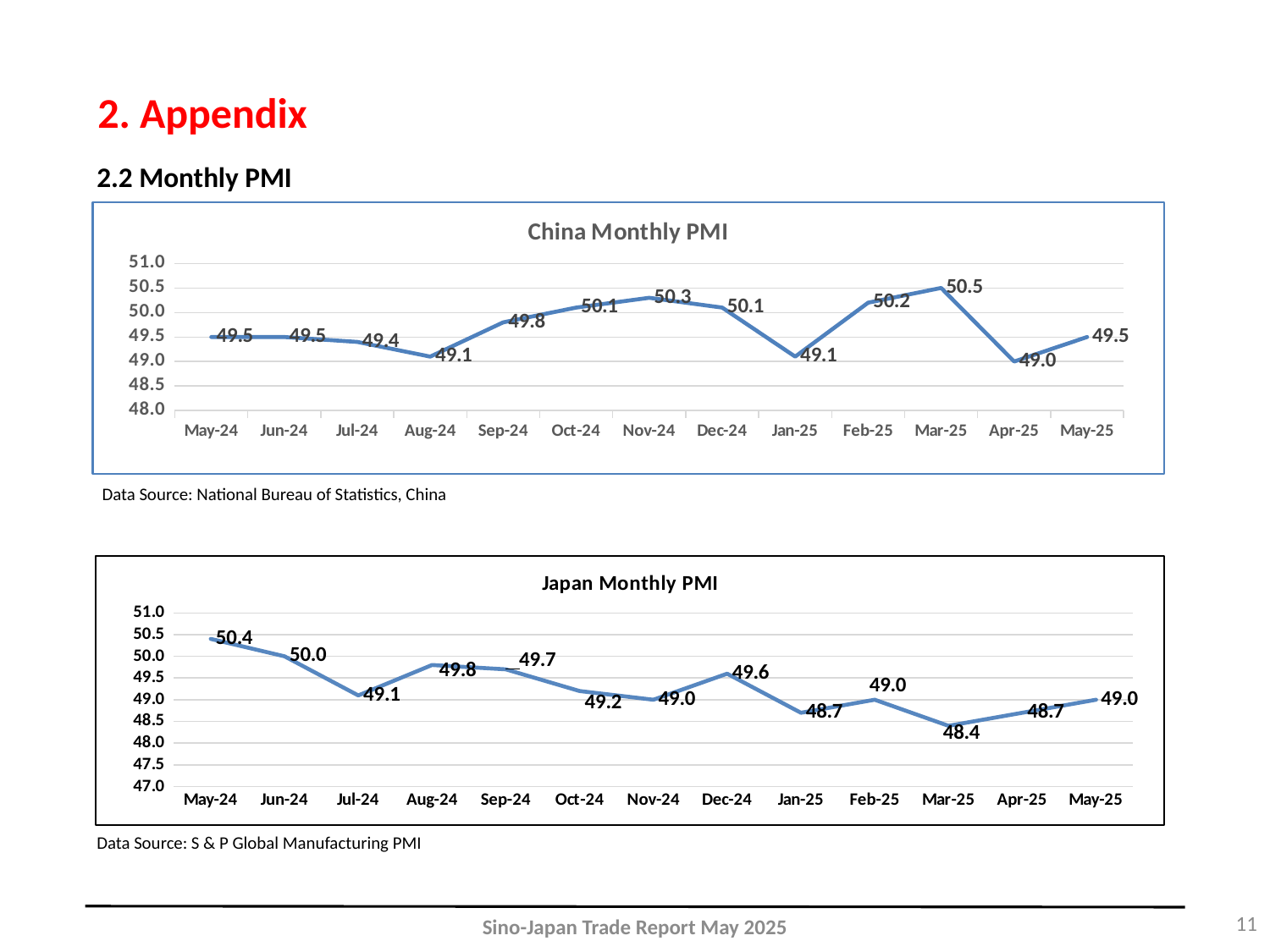
In the China Monthly PMI chart, what is the difference between the Nov-24 value and the Aug-24 value? 1.2 In the China Monthly PMI chart, which month has the highest value? Mar-25 In the China Monthly PMI chart, what is the value for Mar-25? 50.5 In the China Monthly PMI chart, which month has the lowest value? Apr-25 In the Japan Monthly PMI chart, which month has the lowest value? Mar-25 What kind of chart is the Japan Monthly PMI chart? Line chart In the China Monthly PMI chart, is the value for Nov-24 greater or less than 50.0? greater In the Japan Monthly PMI chart, which is larger, the value for Dec-24 or the value for Jan-25? Dec-24 In the Japan Monthly PMI chart, which month has the highest value? May-24 In the China Monthly PMI chart, how many months are plotted? 13 In the Japan Monthly PMI chart, what is the value for Mar-25? 48.4 In the Japan Monthly PMI chart, what is the difference between the May-24 value and the May-25 value? 1.4